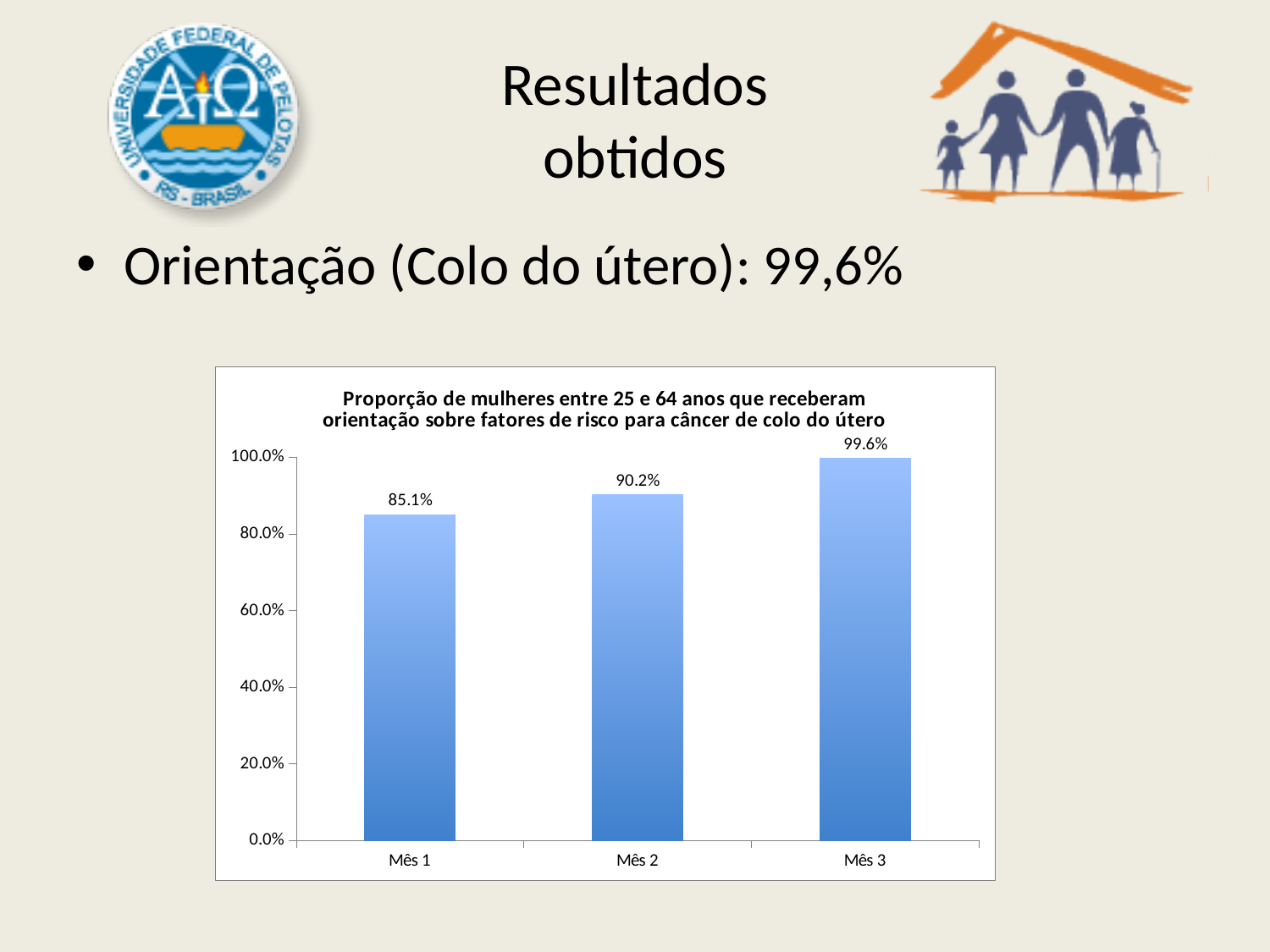
What is the value for Mês 1? 85.1% Is the value for Mês 1 greater or less than 80.0%? greater What is the difference between the values for Mês 2 and Mês 1? 5.1% What is the difference between the values for Mês 3 and Mês 1? 14.5% What kind of chart is shown on the slide? bar chart Which month has the lowest value? Mês 1 Which is larger, the value for Mês 1 or the value for Mês 2? Mês 2 Do the values rise or fall from Mês 1 to Mês 3? rise How many months are shown on the x axis? 3 Which month has the highest value? Mês 3 What is the value for Mês 2? 90.2% What is the value for Mês 3? 99.6%